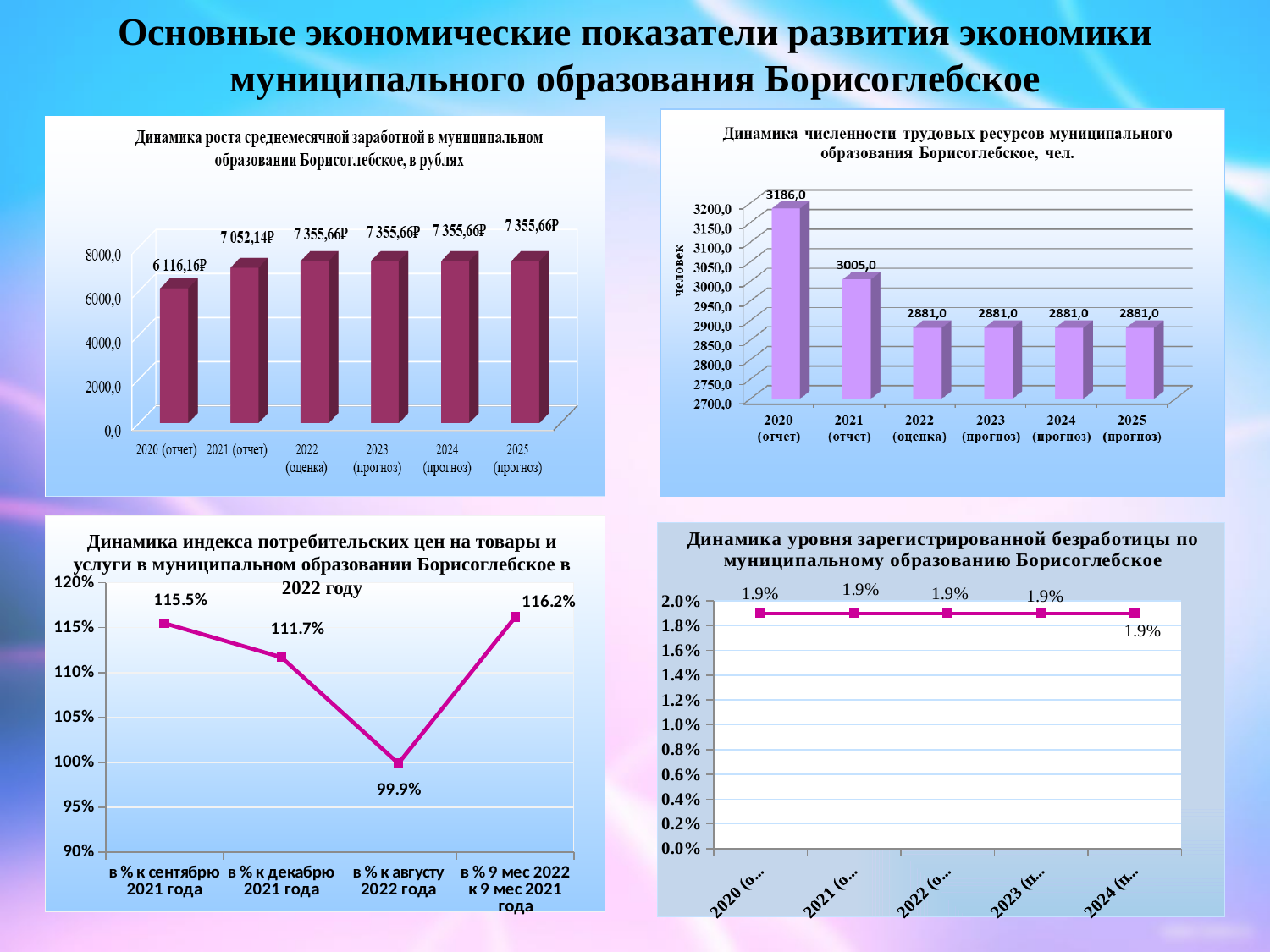
On the chart 'Динамика численности трудовых ресурсов муниципального образования Борисоглебское, чел.', what is the value for 2023 (прогноз)? 2881,0 On the chart 'Динамика численности трудовых ресурсов муниципального образования Борисоглебское, чел.', do the values rise or fall from 2020 to 2022? fall On the chart 'Динамика роста среднемесячной заработной в муниципальном образовании Борисоглебское, в рублях', which year has the lowest value? 2020 (отчет) On the chart 'Динамика уровня зарегистрированной безработицы по муниципальному образованию Борисоглебское', how many data points are plotted? 5 On the chart 'Динамика численности трудовых ресурсов муниципального образования Борисоглебское, чел.', what is the value for 2020 (отчет)? 3186,0 On the chart 'Динамика численности трудовых ресурсов муниципального образования Борисоглебское, чел.', what is the difference between the 2020 (отчет) and 2021 (отчет) values? 181,0 On the chart 'Динамика роста среднемесячной заработной в муниципальном образовании Борисоглебское, в рублях', what is the value for 2021 (отчет)? 7 052,14₽ On the chart 'Динамика индекса потребительских цен на товары и услуги в муниципальном образовании Борисоглебское в 2022 году', what is the value for 'в % к августу 2022 года'? 99.9% On the chart 'Динамика индекса потребительских цен на товары и услуги в муниципальном образовании Борисоглебское в 2022 году', which category has the highest value? в % 9 мес 2022 к 9 мес 2021 года On the chart 'Динамика роста среднемесячной заработной в муниципальном образовании Борисоглебское, в рублях', how many bars are plotted? 6 What kind of chart is 'Динамика индекса потребительских цен на товары и услуги в муниципальном образовании Борисоглебское в 2022 году'? line chart On the chart 'Динамика роста среднемесячной заработной в муниципальном образовании Борисоглебское, в рублях', what is the value for 2020 (отчет)? 6 116,16₽